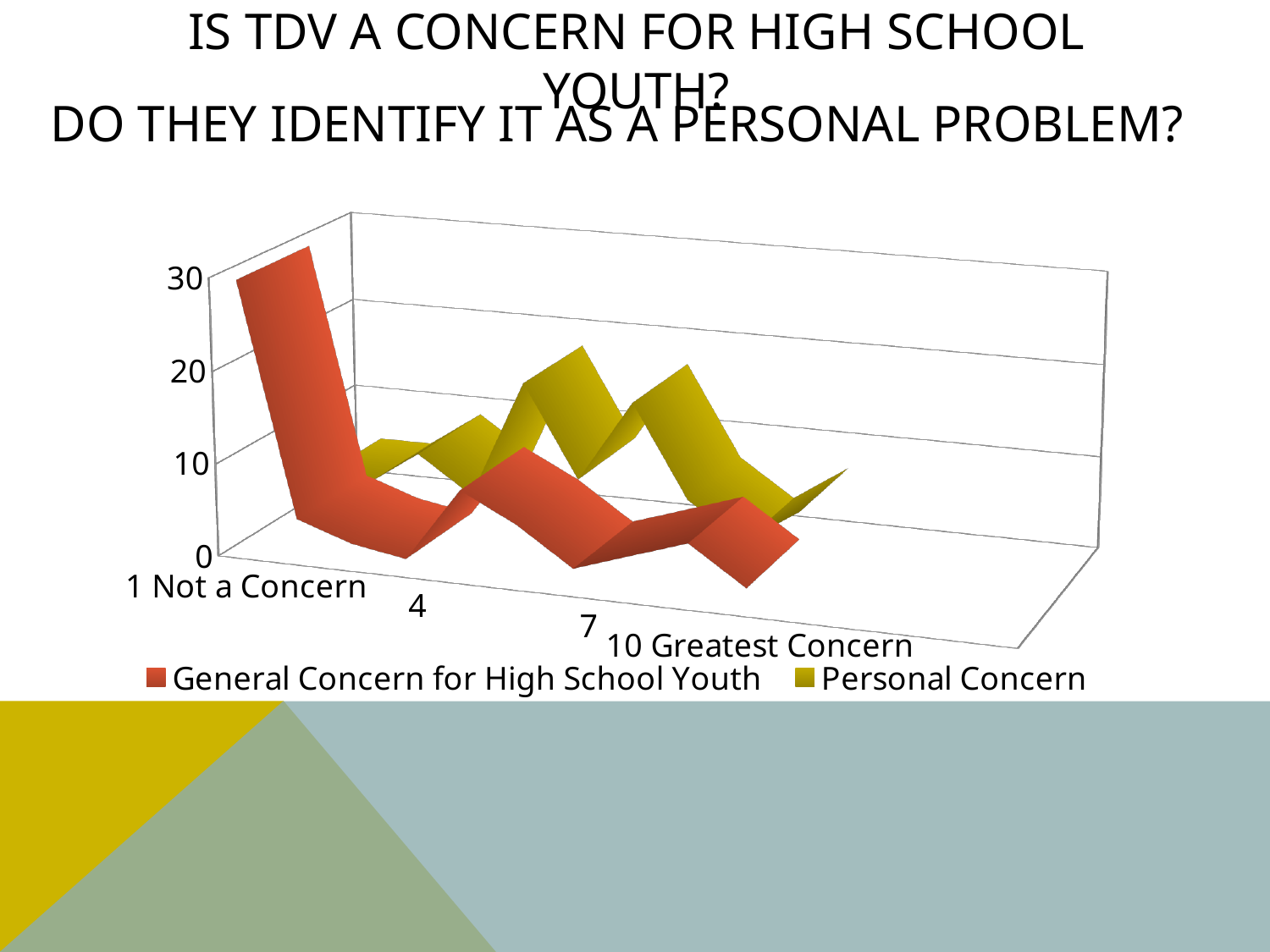
At which category does the General Concern for High School Youth series reach its highest value? 1 Not a Concern How many series does the legend list? 2 Which series is shown in red? General Concern for High School Youth At "1 Not a Concern", which series has the larger value: General Concern for High School Youth or Personal Concern? General Concern for High School Youth What is the highest value shown on the vertical axis? 30 Is the value for General Concern for High School Youth at "1 Not a Concern" greater or less than 20? greater Which series is shown in yellow? Personal Concern What kind of chart is shown on the slide? line chart Does the General Concern for High School Youth series rise or fall from "1 Not a Concern" to 4? fall